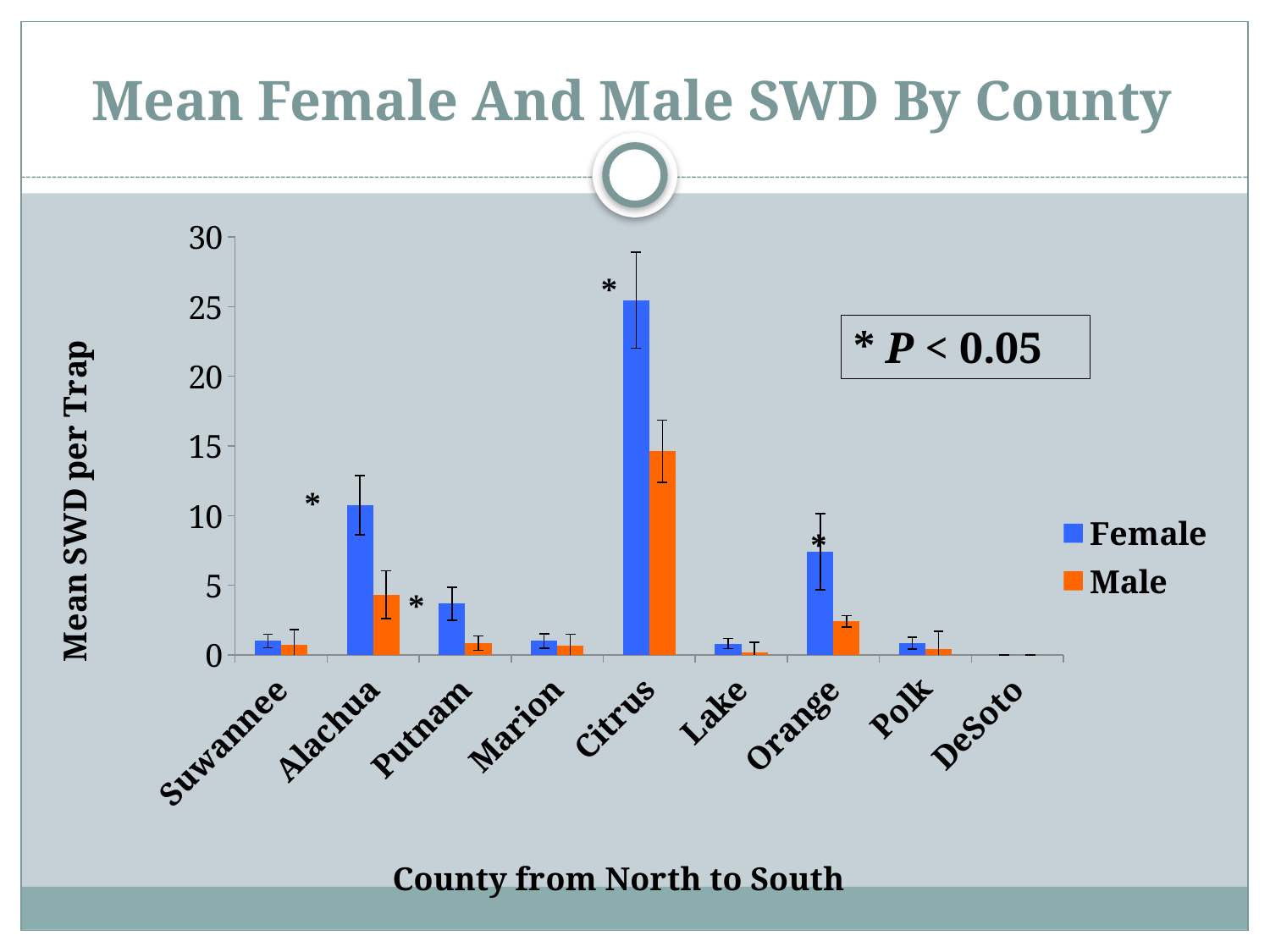
What is the label of the y axis? Mean SWD per Trap Is the Female value for Orange greater or less than 5? greater What is the label of the x axis? County from North to South How many counties are shown on the x axis? 9 What kind of chart is shown on the slide? bar chart Which is larger for Alachua, the Female value or the Male value? Female How many series does the legend list? 2 Which county has the highest Female value? Citrus Is the Female value for Alachua greater or less than 10? greater Which county has the highest Male value? Citrus